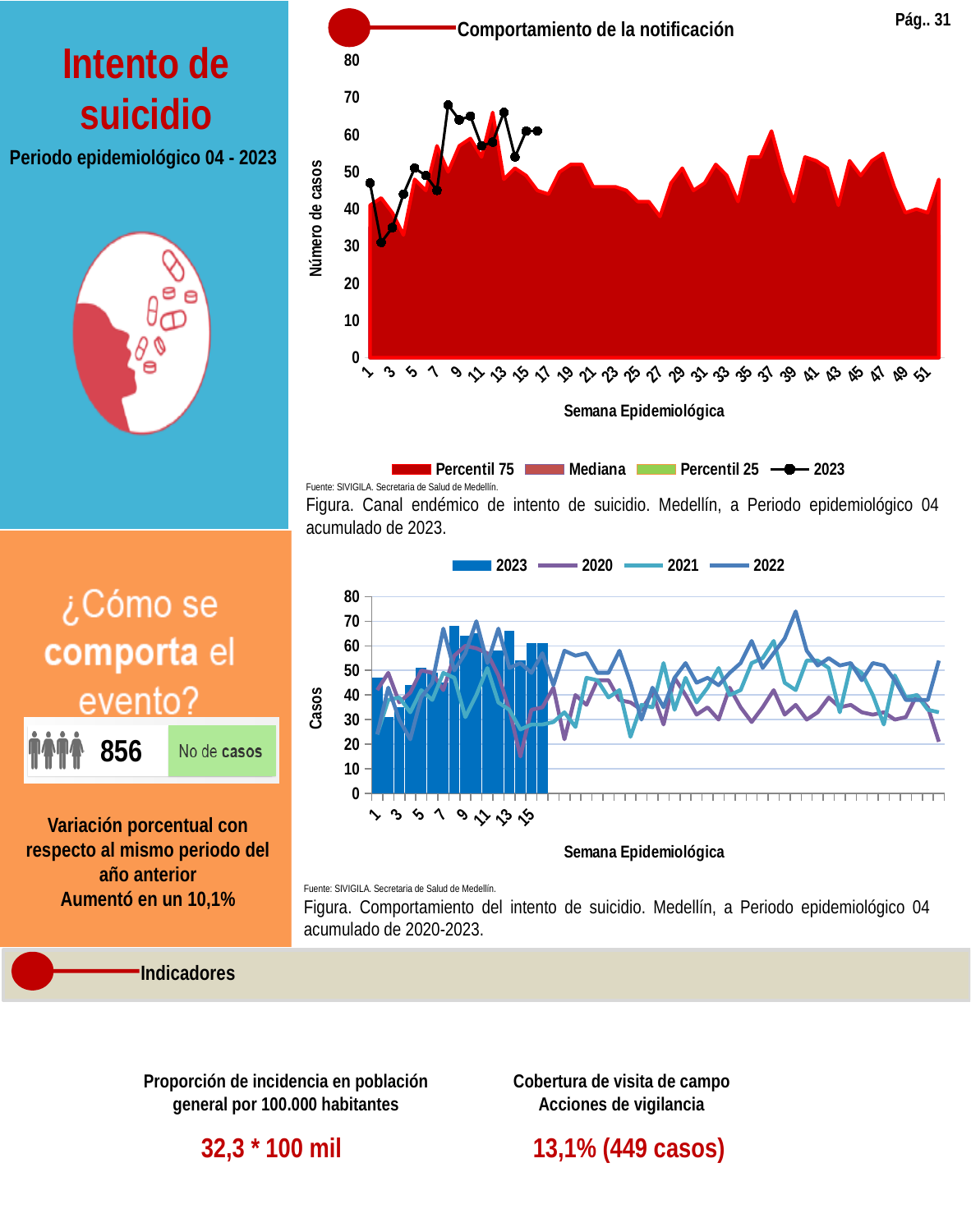
In the top chart 'Comportamiento de la notificación', what is the y-axis title? Número de casos In the bottom chart (Comportamiento del intento de suicidio 2020-2023), how many series does the legend list? 4 In the top chart 'Comportamiento de la notificación', which is larger for the 2023 series: week 2 or week 8? week 8 In the bottom chart (Comportamiento del intento de suicidio 2020-2023), what kind of chart is used for the 2023 series? bar chart In the top chart 'Comportamiento de la notificación', is the 2023 value for week 8 greater or less than 60? greater In the top chart 'Comportamiento de la notificación', is the 2023 value for week 2 greater or less than 40? less In the bottom chart (Comportamiento del intento de suicidio 2020-2023), what is the x-axis title? Semana Epidemiológica In the bottom chart (Comportamiento del intento de suicidio 2020-2023), which is larger for the 2023 series: week 3 or week 8? week 8 In the top chart 'Comportamiento de la notificación', how many series does the legend list? 4 In the bottom chart (Comportamiento del intento de suicidio 2020-2023), do the 2023 bars generally rise or fall from week 1 to week 8? rise In the bottom chart (Comportamiento del intento de suicidio 2020-2023), is the 2023 value for week 3 greater or less than 40? less